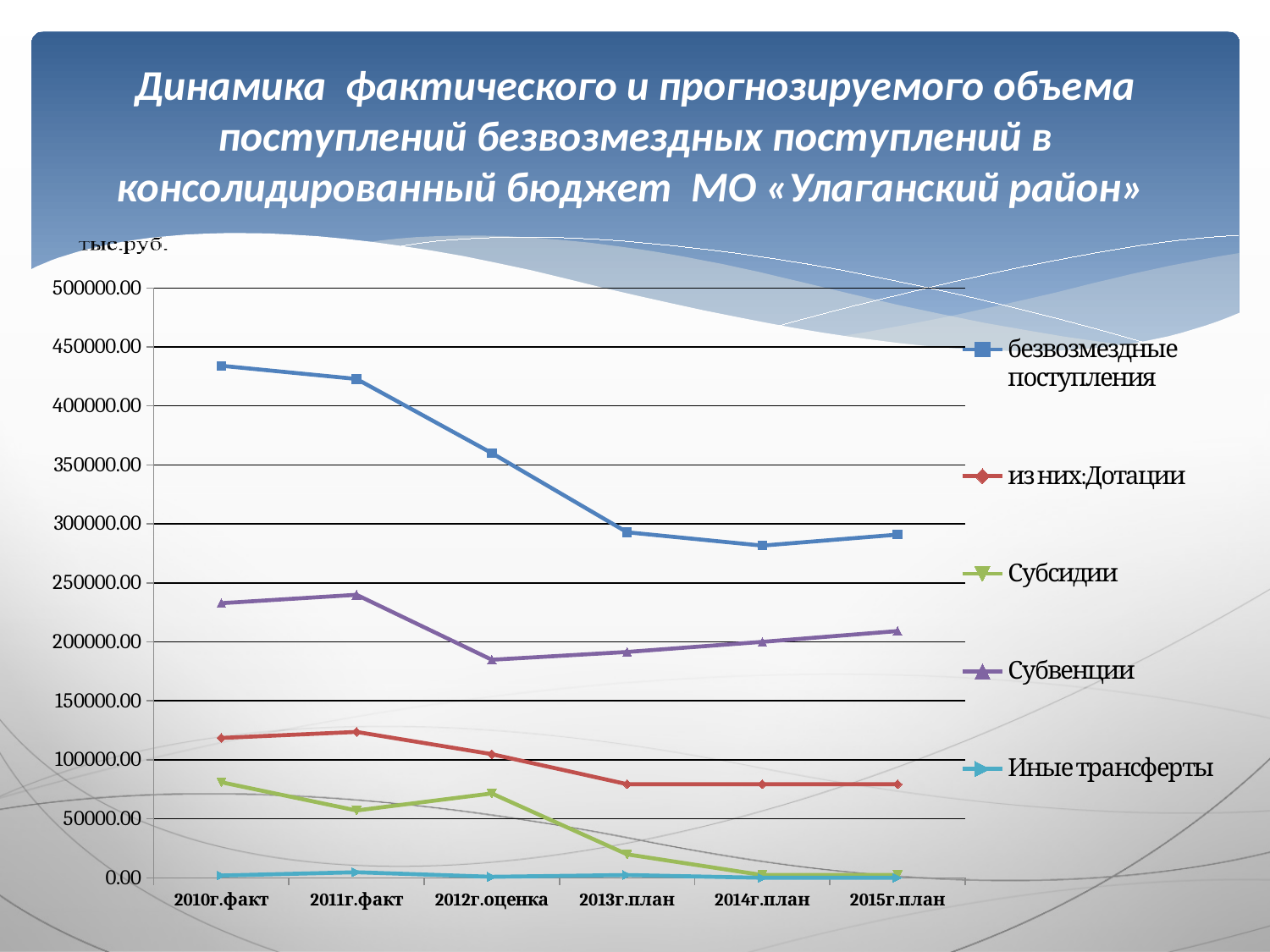
Does the value for безвозмездные поступления rise or fall from 2010г.факт to 2014г.план? fall Is the value for Субвенции in 2012г.оценка greater or less than 200000.00? less In which category is the value for безвозмездные поступления highest? 2010г.факт Is the value for безвозмездные поступления in 2013г.план greater or less than 300000.00? less What unit is written above the vertical axis? тыс.руб. Is the value for безвозмездные поступления in 2010г.факт greater or less than 400000.00? greater How many categories are shown along the x axis? 6 In 2010г.факт, which is larger: Субвенции or из них:Дотации? Субвенции What type of chart is shown on the slide? line chart How many series does the legend list? 5 In 2012г.оценка, which is larger: из них:Дотации or Субсидии? из них:Дотации